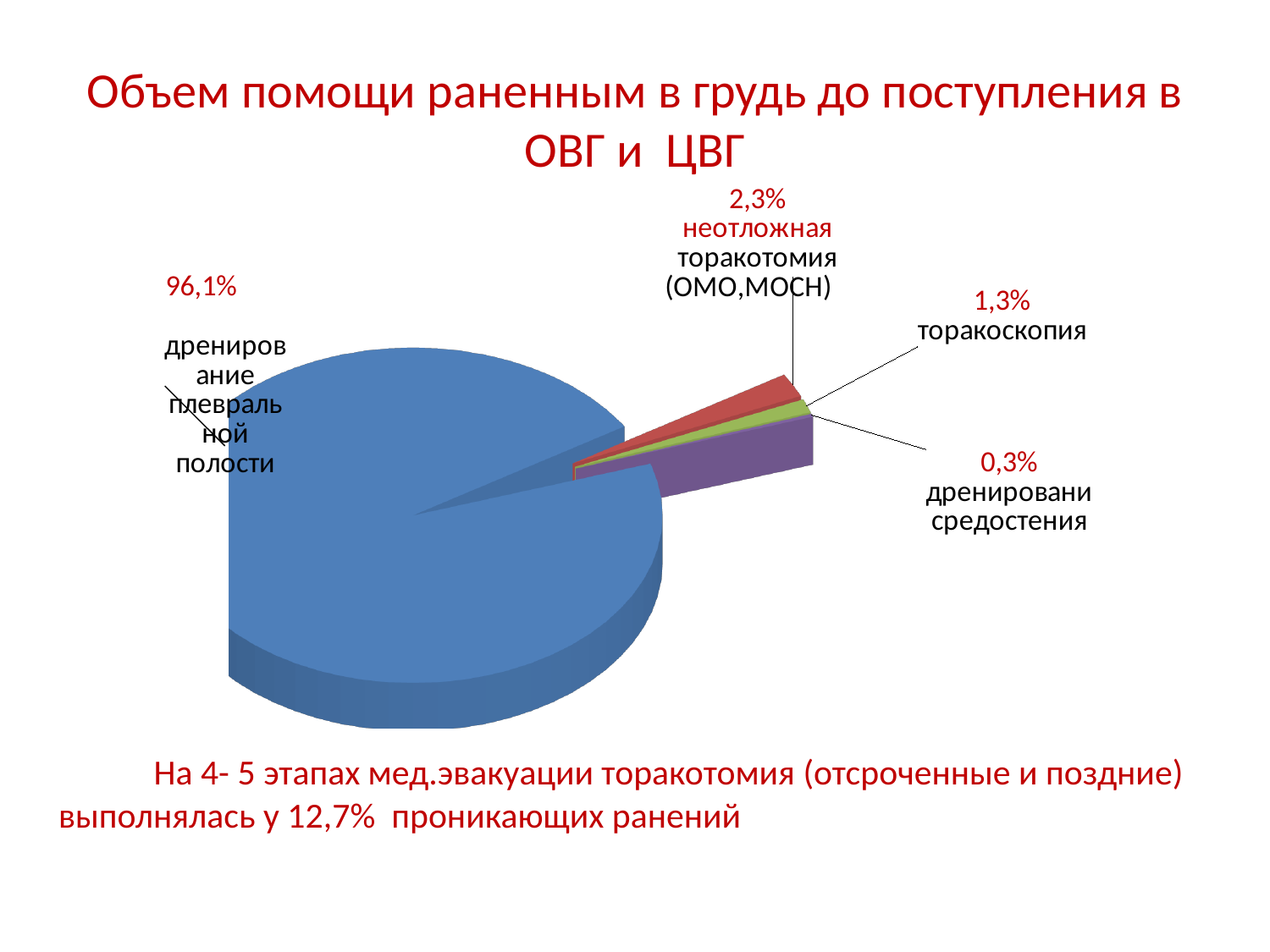
What colour is the largest slice of the pie chart? blue What is the difference in percentage points between "неотложная торакотомия (ОМО,МОСН)" and "торакоскопия"? 1,0% Which category has the largest slice of the pie? дренирование плевральной полости What percentage is shown for "торакоскопия"? 1,3% What percentage is shown for "неотложная торакотомия (ОМО,МОСН)"? 2,3% How many slices does the pie chart have? 4 Which category has the smallest slice of the pie? дренировани средостения What share of the pie is labelled "дренирование плевральной полости"? 96,1% What is the difference in percentage points between "торакоскопия" and "дренировани средостения"? 1,0% What percentage is shown for "дренировани средостения"? 0,3% What kind of chart is shown on the slide? pie chart Which is larger: the share for "неотложная торакотомия (ОМО,МОСН)" or the share for "торакоскопия"? неотложная торакотомия (ОМО,МОСН)